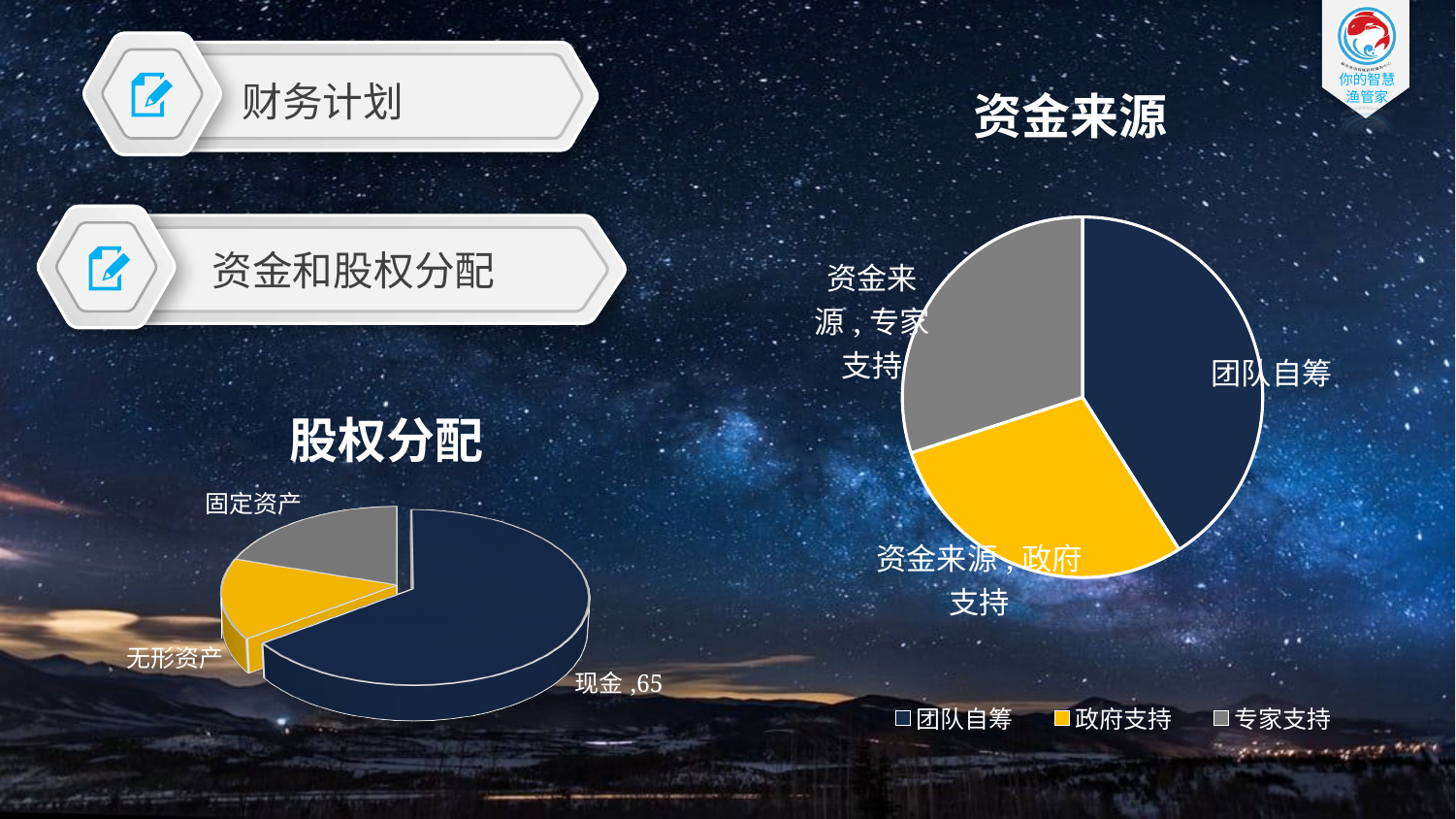
How many slices does the 股权分配 pie chart have? 3 How many entries does the legend of the 资金来源 chart list? 3 What type of chart is the 股权分配 chart? pie chart In the 资金来源 chart, which category has the largest slice? 团队自筹 What type of chart is the 资金来源 chart? pie chart In the 股权分配 chart, which category has the largest slice? 现金 In the 资金来源 chart, what colour is the 政府支持 slice? yellow In the 股权分配 chart, what is the value for 现金? 65 In the 股权分配 chart, which slice is larger, 现金 or 固定资产? 现金 How many slices does the 资金来源 pie chart have? 3 In the 资金来源 chart, which slice is larger, 团队自筹 or 政府支持? 团队自筹 What is the title of the chart on the right side of the slide? 资金来源